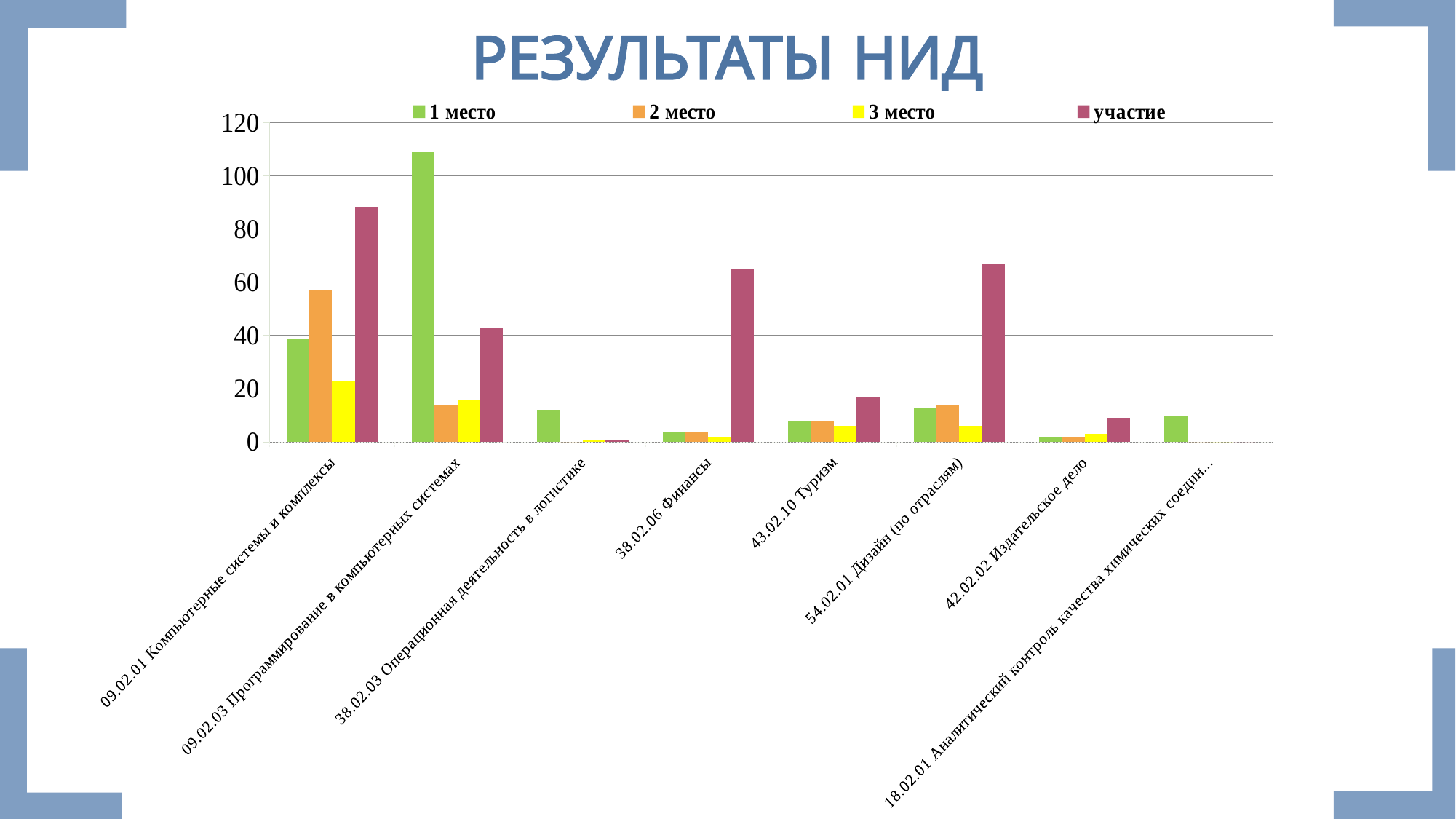
Is the value of "1 место" for 09.02.03 Программирование в компьютерных системах greater or less than 100? greater Which category has the highest value for the series "1 место"? 09.02.03 Программирование в компьютерных системах Is the value of "участие" for 38.02.06 Финансы greater or less than 40? greater Is the value of "1 место" for 38.02.03 Операционная деятельность в логистике greater or less than 20? less Which category has the highest value for the series "участие"? 09.02.01 Компьютерные системы и комплексы How many series does the legend list? 4 Which is larger: the "участие" value for 09.02.01 Компьютерные системы и комплексы or for 09.02.03 Программирование в компьютерных системах? 09.02.01 Компьютерные системы и комплексы Which category has the highest value for the series "2 место"? 09.02.01 Компьютерные системы и комплексы What kind of chart is shown on the slide? bar chart How many categories are shown on the x axis? 8 What is the title of the slide above the chart? РЕЗУЛЬТАТЫ НИД